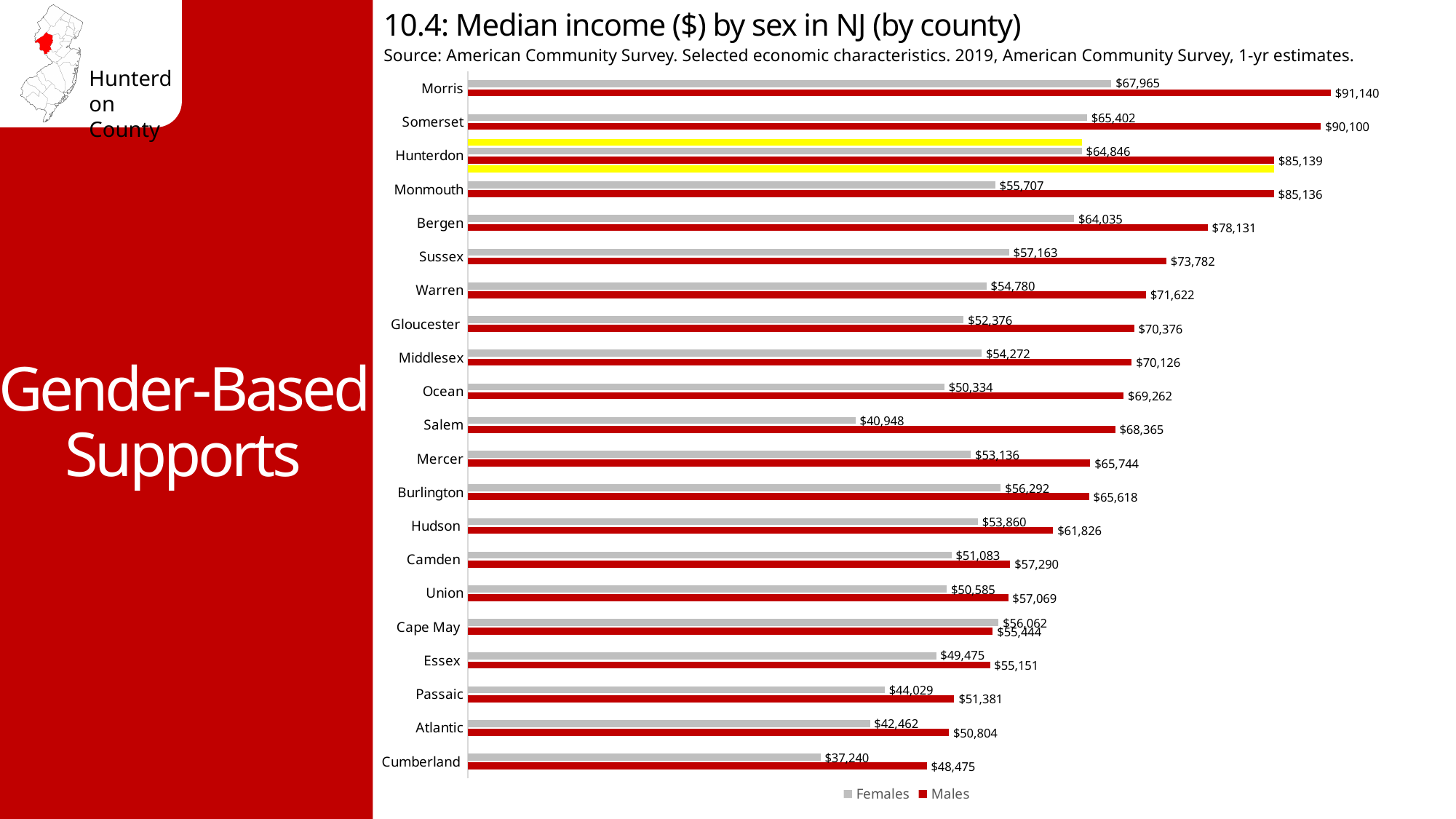
Which county has the highest median income for Males? Morris What is the median income for Males in Monmouth County? $85,136 How many series does the legend list? 2 Which county has the lowest median income for Females? Cumberland What is the median income for Females in Hunterdon County? $64,846 How many counties are shown in the chart? 21 What is the median income for Females in Salem County? $40,948 What is the difference between the Males and Females median income in Hunterdon County? $20,293 Which is larger: the Males median income in Bergen County or in Sussex County? Bergen In Cape May County, which is larger: the Females or the Males median income? Females What is the difference between the Males and Females median income in Morris County? $23,175 What type of chart is shown on the slide? Bar chart